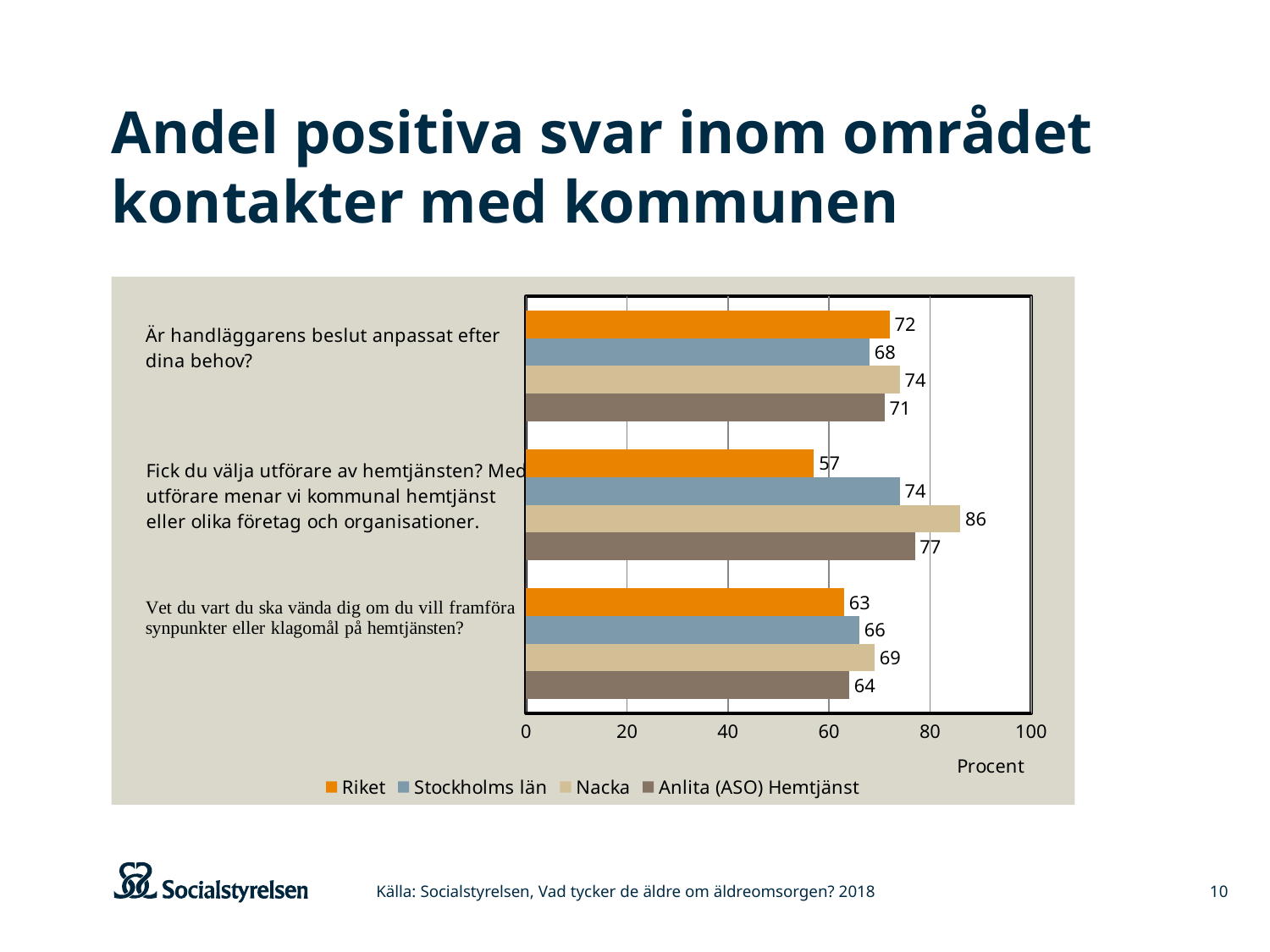
How many series does the legend list? 4 What unit label is shown on the x axis of the chart? Procent What is the difference between Nacka and Riket on the question "Fick du välja utförare av hemtjänsten?"? 29 How many question categories are plotted on the chart? 3 What is the value for Nacka on the question "Fick du välja utförare av hemtjänsten?"? 86 What is the value for Anlita (ASO) Hemtjänst on the question "Fick du välja utförare av hemtjänsten?"? 77 What kind of chart is shown on the slide? Bar chart What is the value for Stockholms län on the question "Vet du vart du ska vända dig om du vill framföra synpunkter eller klagomål på hemtjänsten?"? 66 Which series has the lowest value on the question "Är handläggarens beslut anpassat efter dina behov?"? Stockholms län What is the value for Riket on the question "Är handläggarens beslut anpassat efter dina behov?"? 72 On the question "Vet du vart du ska vända dig om du vill framföra synpunkter eller klagomål på hemtjänsten?", which is larger: Nacka or Anlita (ASO) Hemtjänst? Nacka Which series has the highest value on the question "Fick du välja utförare av hemtjänsten?"? Nacka